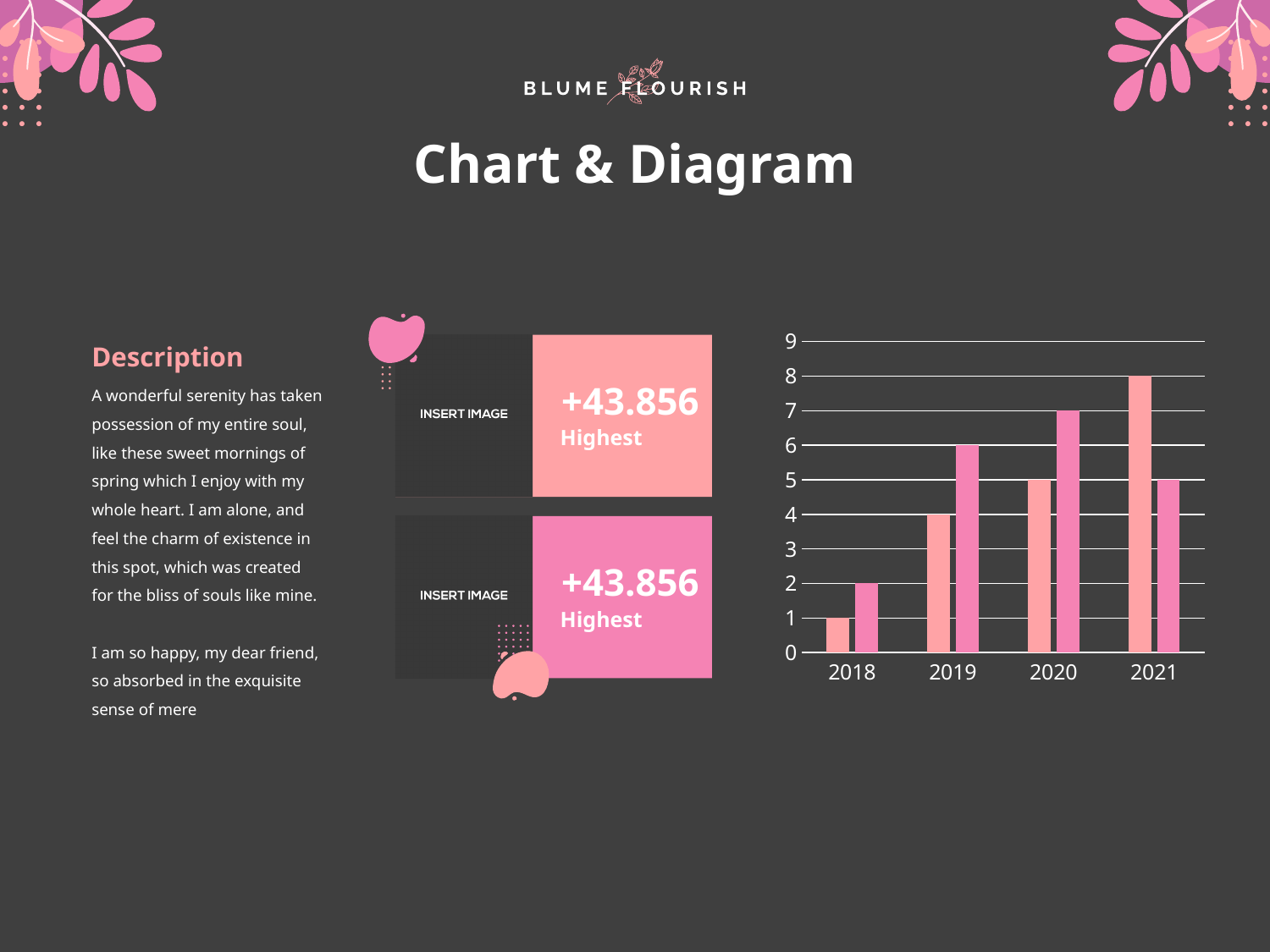
In 2021, which bar is taller, the light pink or the dark pink? light pink What type of chart is shown on the slide? bar chart What is the value of the dark pink bar for 2020? 7 What is the value of the light pink bar for 2021? 8 Do the light pink bars rise or fall from 2018 to 2021? rise What is the value of the dark pink bar for 2019? 6 What is the difference between the dark pink bar and the light pink bar in 2019? 2 In which year is the light pink bar highest? 2021 What is the value of the light pink bar for 2018? 1 What is the highest value shown on the chart's y axis? 9 In which year is the dark pink bar lowest? 2018 How many years are shown on the x axis of the chart? 4